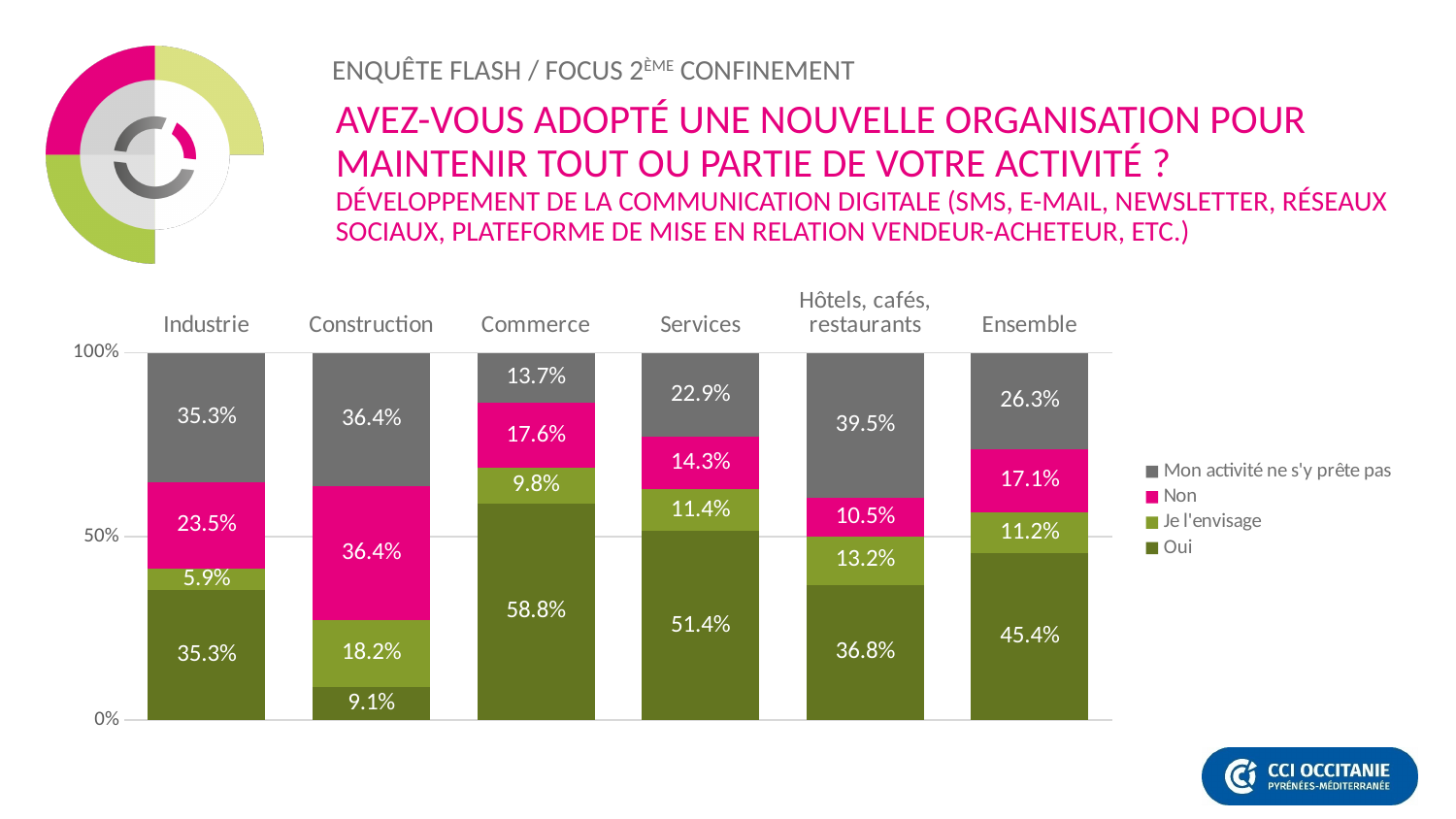
Which is larger: the "Non" value for Industrie or the "Non" value for Ensemble? Industrie What is the difference between the "Oui" values for Commerce and Services? 7.4% What is the value of "Je l'envisage" for Industrie? 5.9% What is the value of "Oui" for Commerce? 58.8% Which category has the highest value for "Oui"? Commerce What is the value of "Mon activité ne s'y prête pas" for Hôtels, cafés, restaurants? 39.5% Which category has the lowest value for "Oui"? Construction How many series does the legend list? 4 How many categories are shown on the x axis? 6 What is the value of "Non" for Construction? 36.4% Which legend entry is shown in pink? Non What kind of chart is shown on the slide? Stacked bar chart